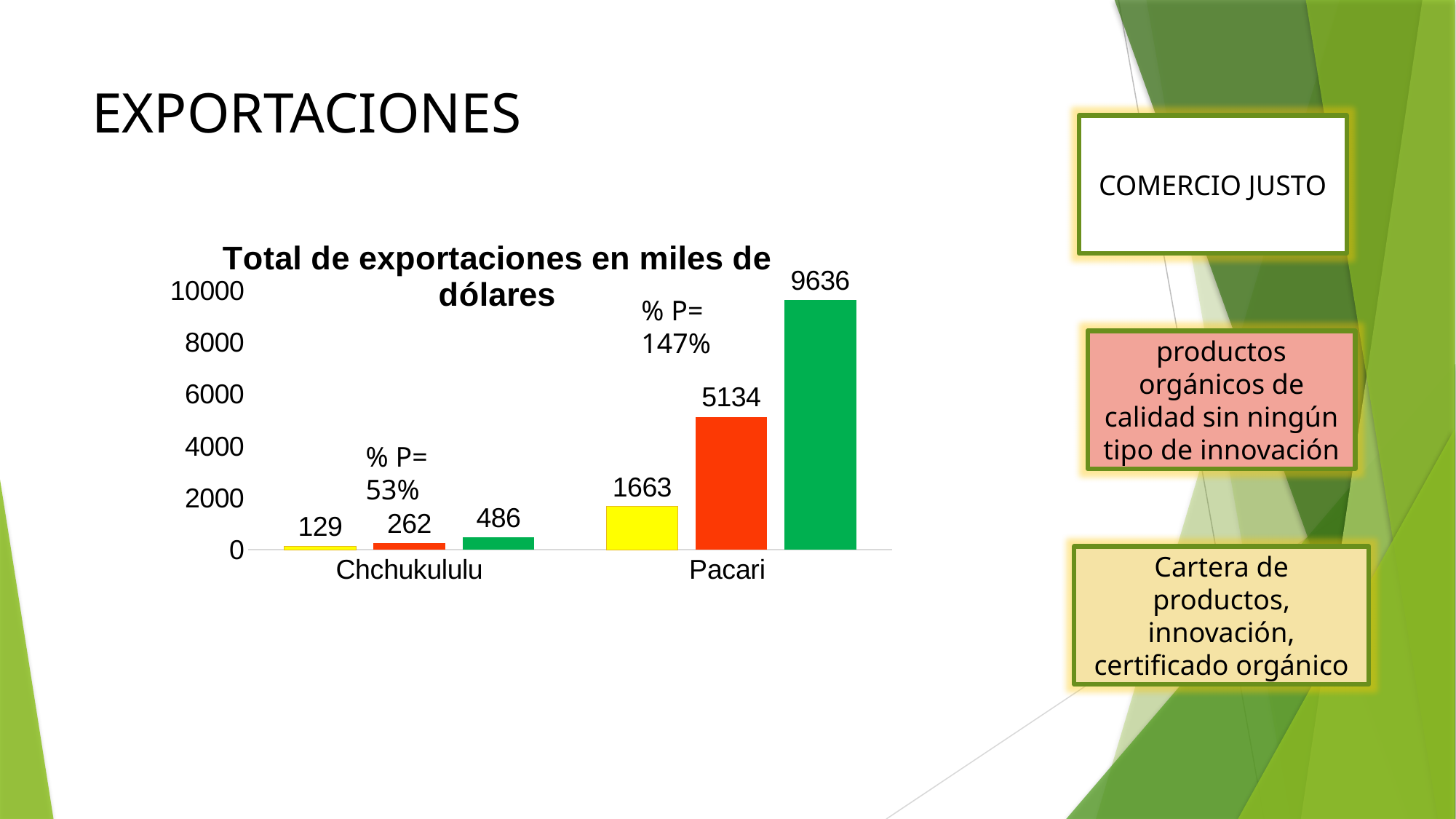
What is the value of the green bar for Chchukululu? 486 Which bar has the highest value in the chart? the green bar for Pacari (9636) What is the value of the yellow bar for Chchukululu? 129 Which bar has the lowest value in the chart? the yellow bar for Chchukululu (129) What is the difference between the green bar and the red bar for Pacari? 4502 What kind of chart is shown on the slide? bar chart What is the value of the red bar for Pacari? 5134 What is the value of the green bar for Pacari? 9636 How many categories are shown on the x axis of the chart? 2 What percentage is annotated above the Pacari bars (% P=)? 147% Which is larger: the yellow bar for Pacari or the green bar for Chchukululu? the yellow bar for Pacari What is the title of the chart? Total de exportaciones en miles de dólares